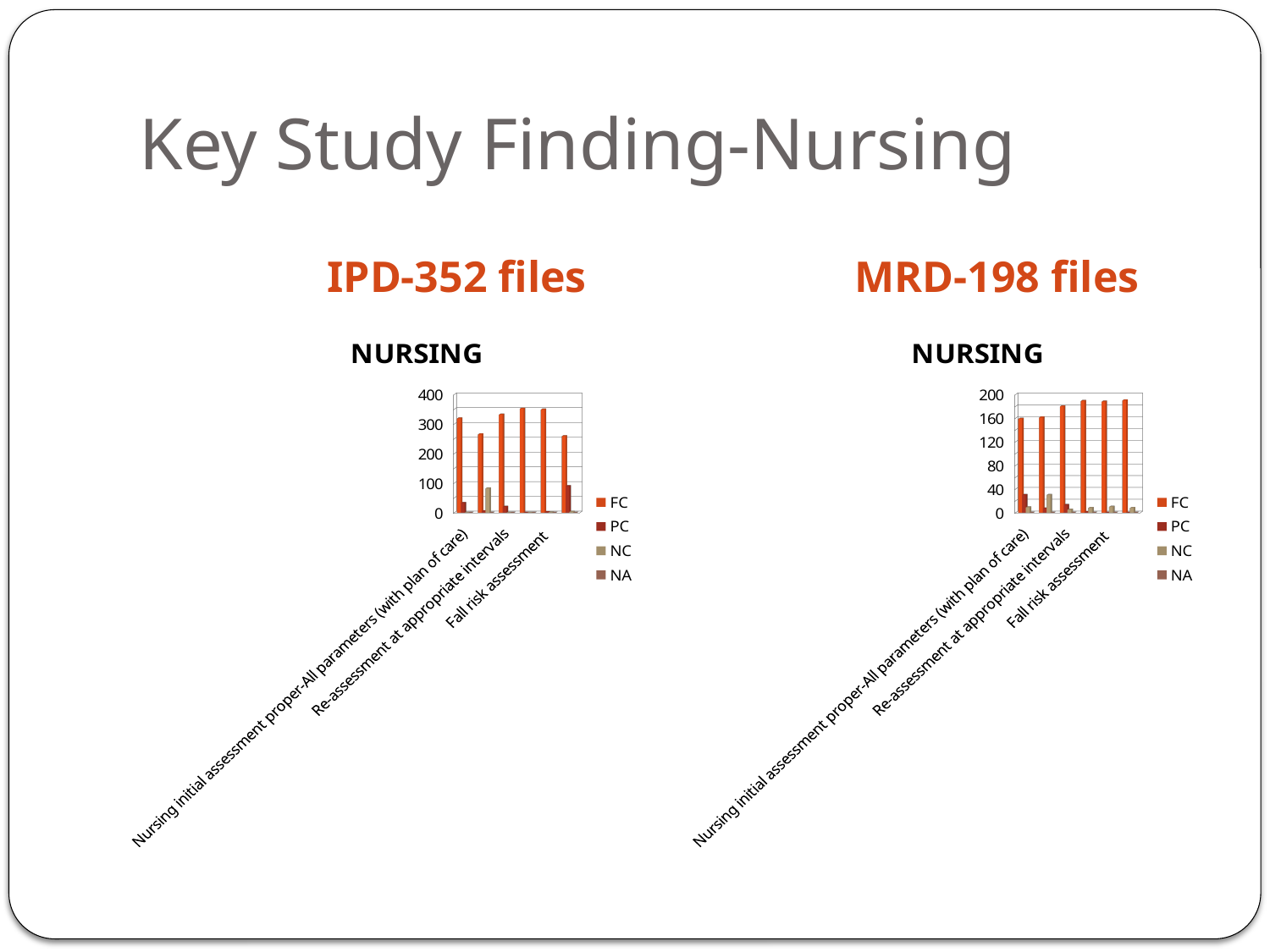
What is the highest value shown on the y axis of the left NURSING chart (IPD-352 files)? 400 In the left NURSING chart (IPD-352 files), which is larger in the leftmost group of bars, FC or PC? FC In the left NURSING chart (IPD-352 files), is the leftmost FC bar greater or less than 300? greater In the right NURSING chart (MRD-198 files), is the rightmost FC bar greater or less than 160? greater In the right NURSING chart (MRD-198 files), which is larger, the leftmost FC bar or the rightmost FC bar? the rightmost FC bar In the left NURSING chart (IPD-352 files), which is larger, the leftmost FC bar or the rightmost FC bar? the leftmost FC bar What are the legend entries of the right NURSING chart (MRD-198 files)? FC, PC, NC, NA In the right NURSING chart (MRD-198 files), is the leftmost FC bar greater or less than 120? greater In the right NURSING chart (MRD-198 files), which series has the tallest bar in every group? FC What kind of chart is the NURSING chart on the left (IPD-352 files)? bar chart How many series does the legend of the left NURSING chart (IPD-352 files) list? 4 How many series does the legend of the right NURSING chart (MRD-198 files) list? 4